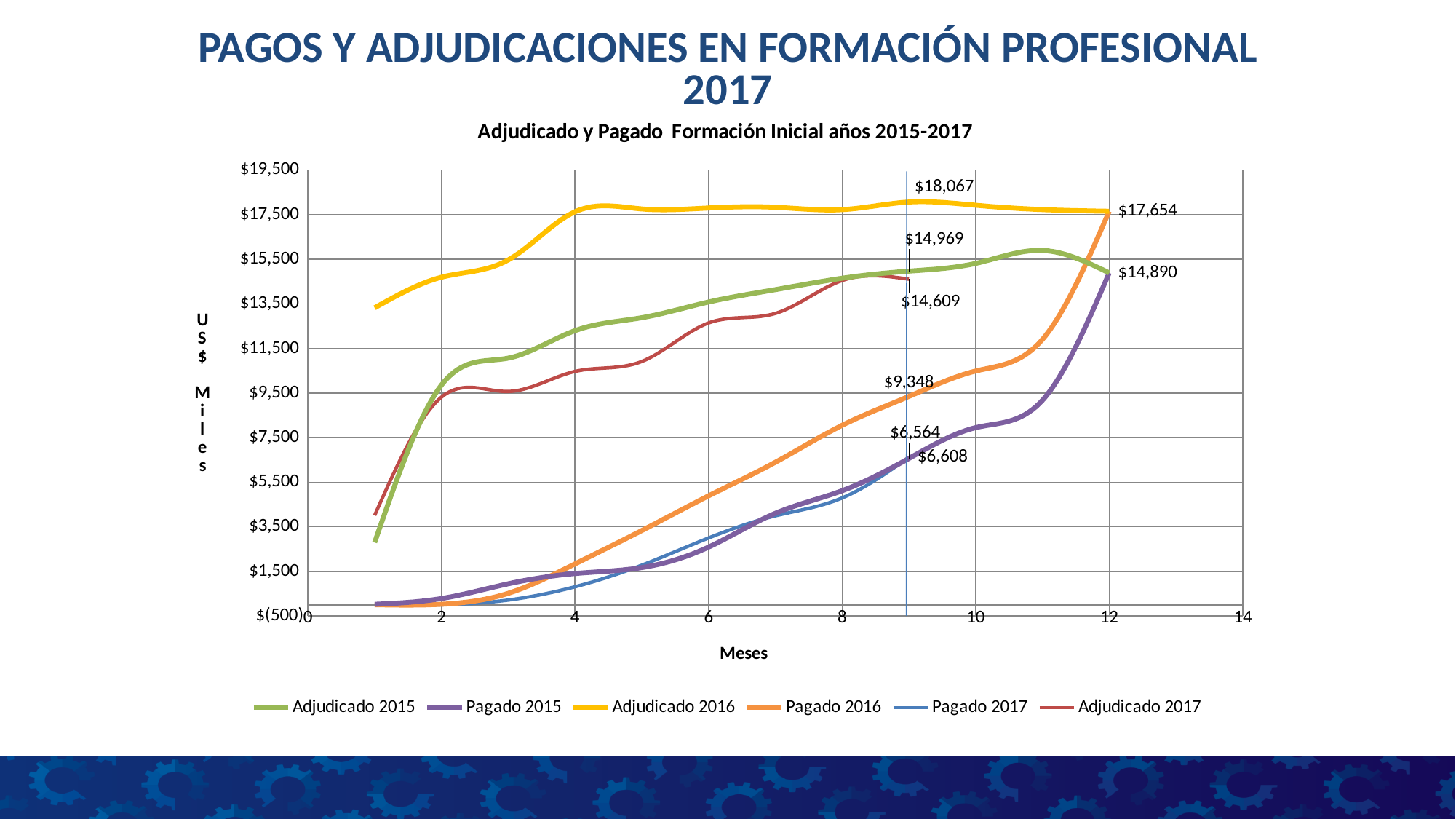
What is the difference between Adjudicado 2016 and Adjudicado 2015 at month 9? $3,098 What is the value of Adjudicado 2015 at month 9? $14,969 What is the value of Pagado 2016 at month 9? $9,348 What kind of chart is shown on the slide? line chart What is the label of the x axis? Meses What is the value of Adjudicado 2016 at month 9? $18,067 Which series has the highest value at month 9? Adjudicado 2016 What is the title of the chart? Adjudicado y Pagado Formación Inicial años 2015-2017 Does the Pagado 2016 series rise or fall as the months increase? rise How many series does the legend list? 6 Is the value for Pagado 2016 at month 6 greater or less than $5,500? less At month 9, which is larger: Adjudicado 2016 or Pagado 2016? Adjudicado 2016